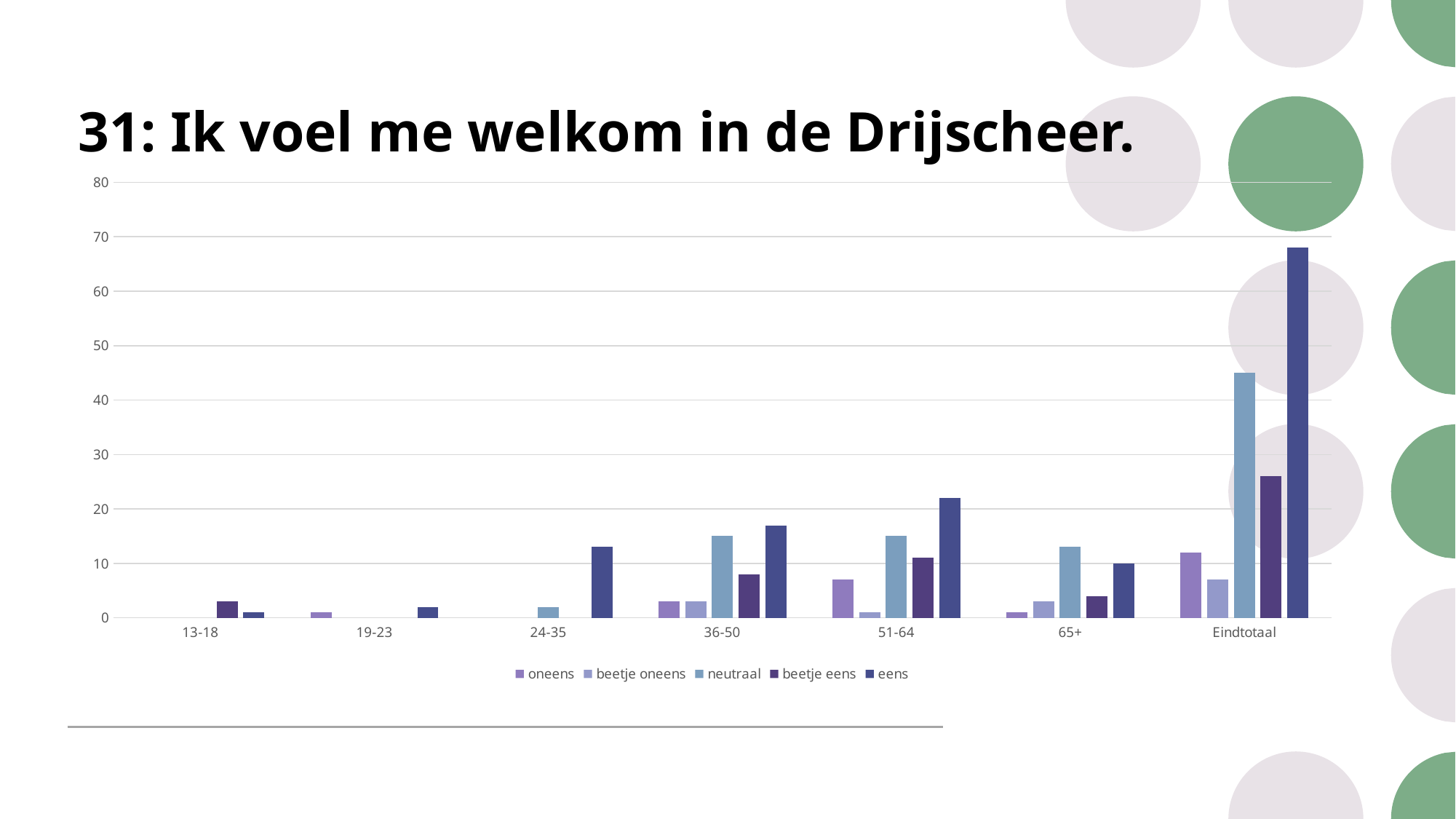
Which category has the tallest bar in the chart? Eindtotaal What kind of chart is shown on the slide? bar chart Is the value for 'eens' in the 51-64 category greater or less than 20? greater Which series has the highest value in the 51-64 category? eens How many series does the legend list? 5 What is the title of the slide? 31: Ik voel me welkom in de Drijscheer. How many age categories are shown on the x axis, including Eindtotaal? 7 Is the value for 'eens' in the Eindtotaal category greater or less than 60? greater Is the value for 'eens' in the 24-35 category greater or less than 10? greater Which series has the highest value in the Eindtotaal category? eens Which is larger in the Eindtotaal category: 'neutraal' or 'beetje eens'? neutraal